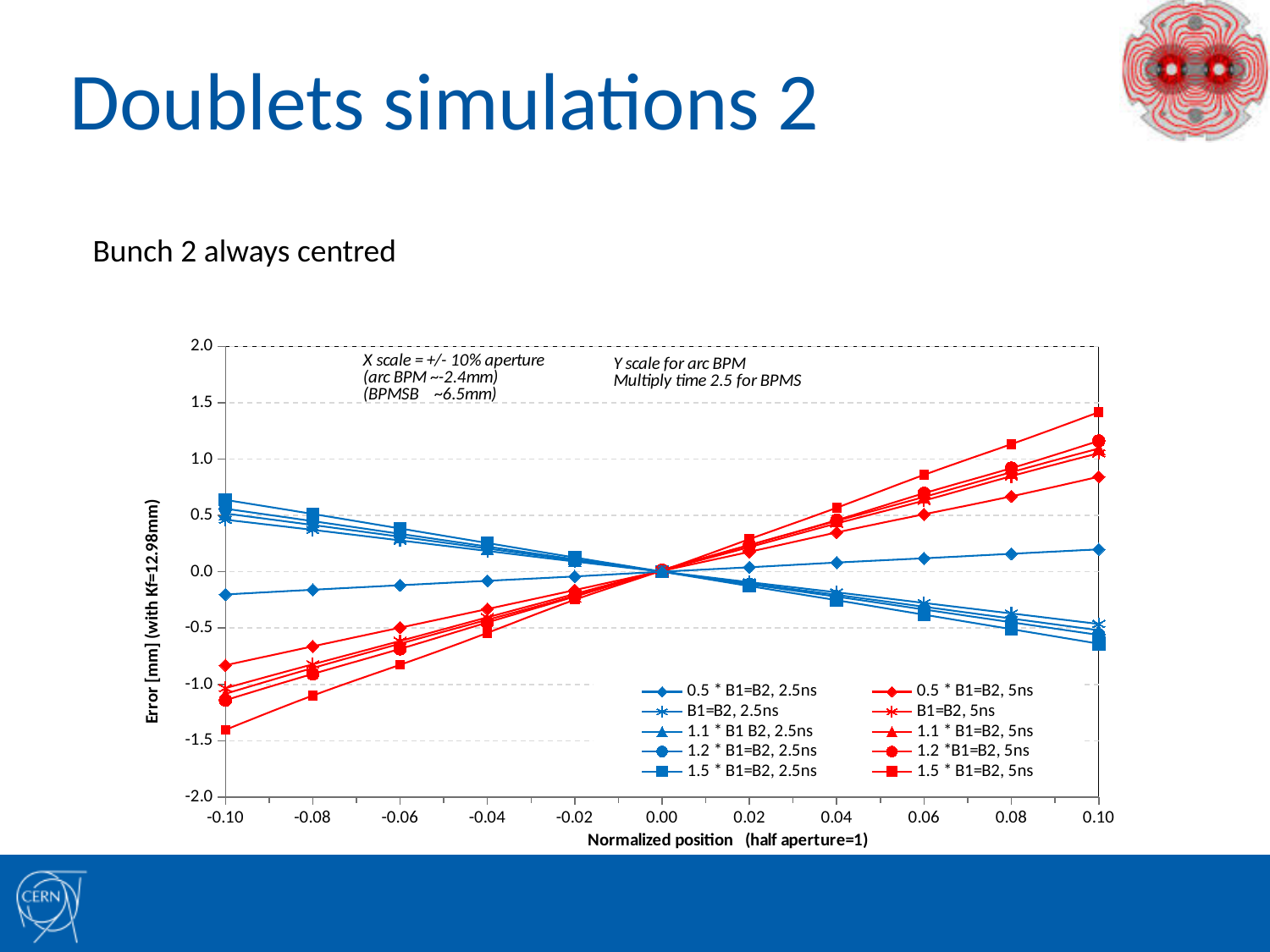
What kind of chart is shown on the slide? Line chart What is the title of the chart's y axis? Error [mm] (with Kf=12.98mm) Does the series '1.5 * B1=B2, 5ns' rise or fall as the normalized position increases from -0.10 to 0.10? Rise Is the value of '1.5 * B1=B2, 5ns' at normalized position 0.10 greater or less than 1.0? greater At normalized position 0.10, which is larger: the value of '1.5 * B1=B2, 5ns' or '0.5 * B1=B2, 5ns'? 1.5 * B1=B2, 5ns How many series does the chart legend list? 10 How many data points does each series have along the x axis? 11 Does the series 'B1=B2, 2.5ns' rise or fall as the normalized position increases from -0.10 to 0.10? Fall Which series has the highest value at normalized position 0.10? 1.5 * B1=B2, 5ns Does the series '0.5 * B1=B2, 2.5ns' rise or fall as the normalized position increases? Rise Is the value of '0.5 * B1=B2, 2.5ns' at normalized position 0.10 greater or less than 0.5? less Is the value of '1.5 * B1=B2, 5ns' at normalized position -0.10 greater or less than -1.0? less